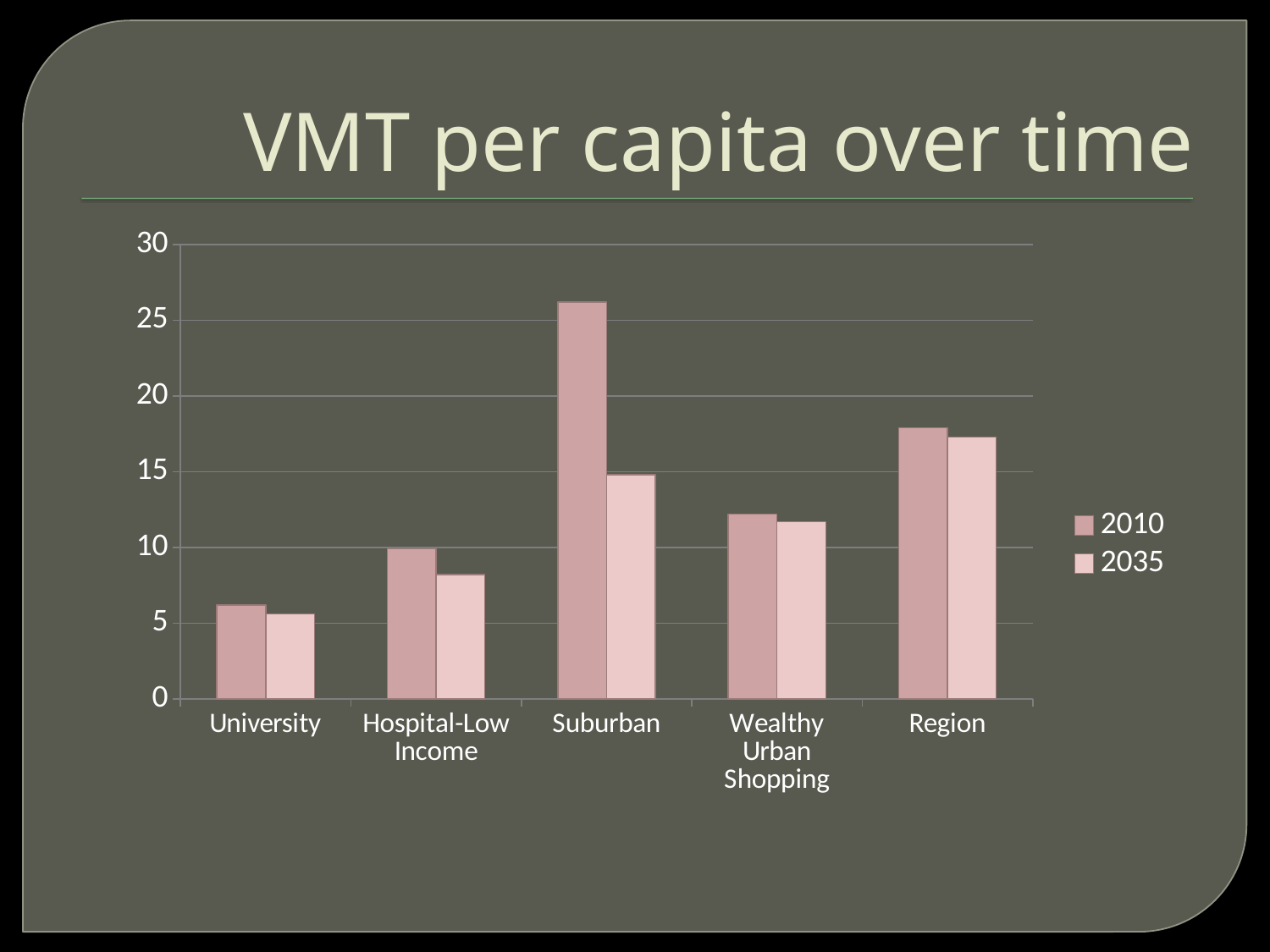
For Suburban, which is larger: the 2010 value or the 2035 value? 2010 How many categories are shown on the x axis? 5 What is the title of the chart? VMT per capita over time Is the 2010 value for Region greater or less than 20? less Is the 2035 value for Hospital-Low Income greater or less than 10? less Is the 2010 value for Suburban greater or less than 25? greater How many series does the legend list? 2 Which is larger: the 2010 value for Region or the 2010 value for Wealthy Urban Shopping? Region Which category has the lowest value for 2035? University What kind of chart is shown on the slide? bar chart Which category has the highest value for 2010? Suburban